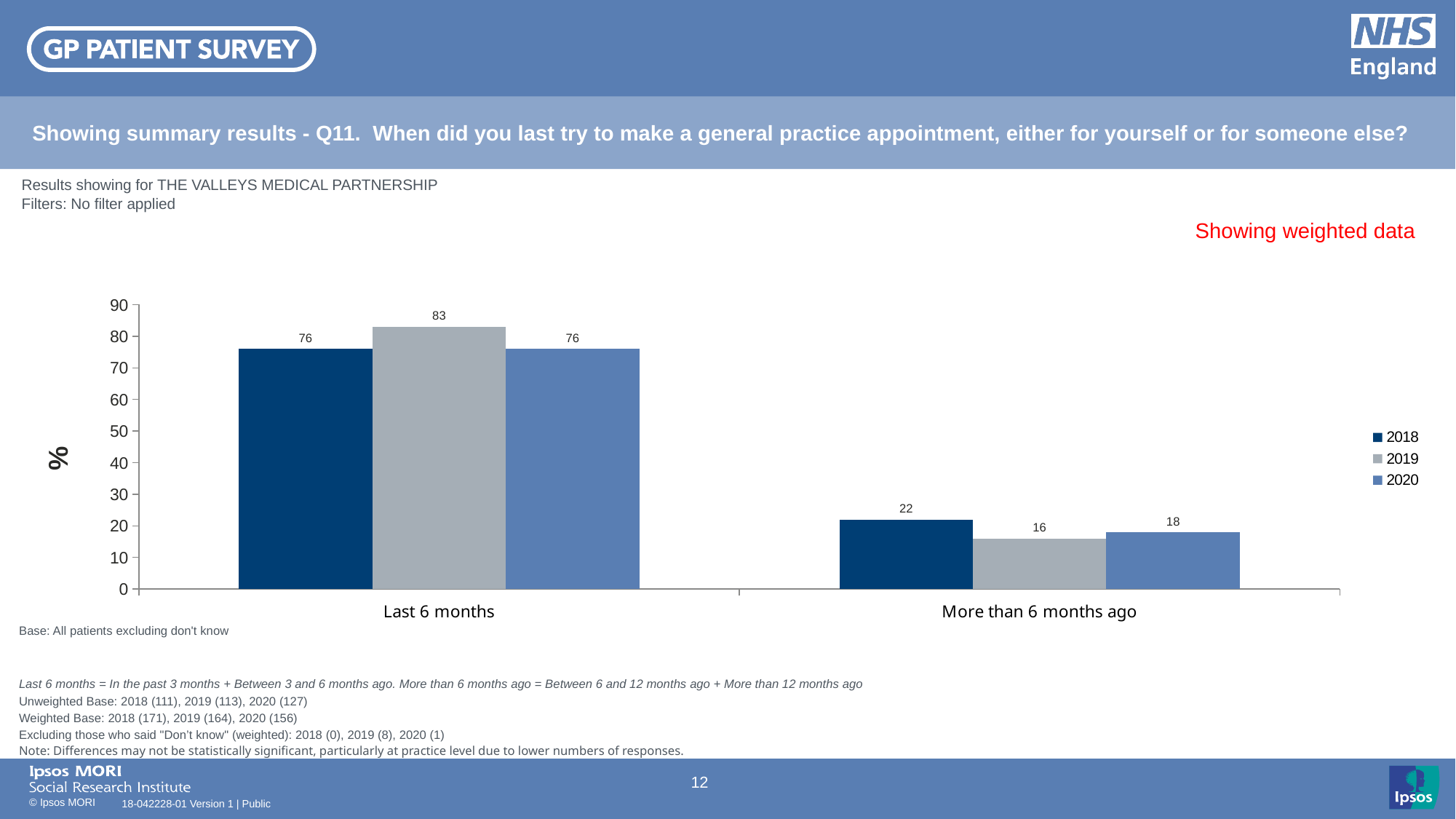
How many series does the legend list? 3 What is the value for 2020 in the 'More than 6 months ago' category? 18 Which year has the highest value in the 'Last 6 months' category? 2019 Which is larger: the 2018 value or the 2020 value in the 'More than 6 months ago' category? 2018 What is the difference between the 2019 and 2018 values in the 'Last 6 months' category? 7 What is the value for 2019 in the 'Last 6 months' category? 83 How many categories are shown on the x axis? 2 What is the difference between the 2018 and 2020 values in the 'More than 6 months ago' category? 4 What kind of chart is shown on the slide? Bar chart What is the value for 2018 in the 'More than 6 months ago' category? 22 Which year has the lowest value in the 'More than 6 months ago' category? 2019 Is the value for 2019 in the 'Last 6 months' category greater or less than 80? greater